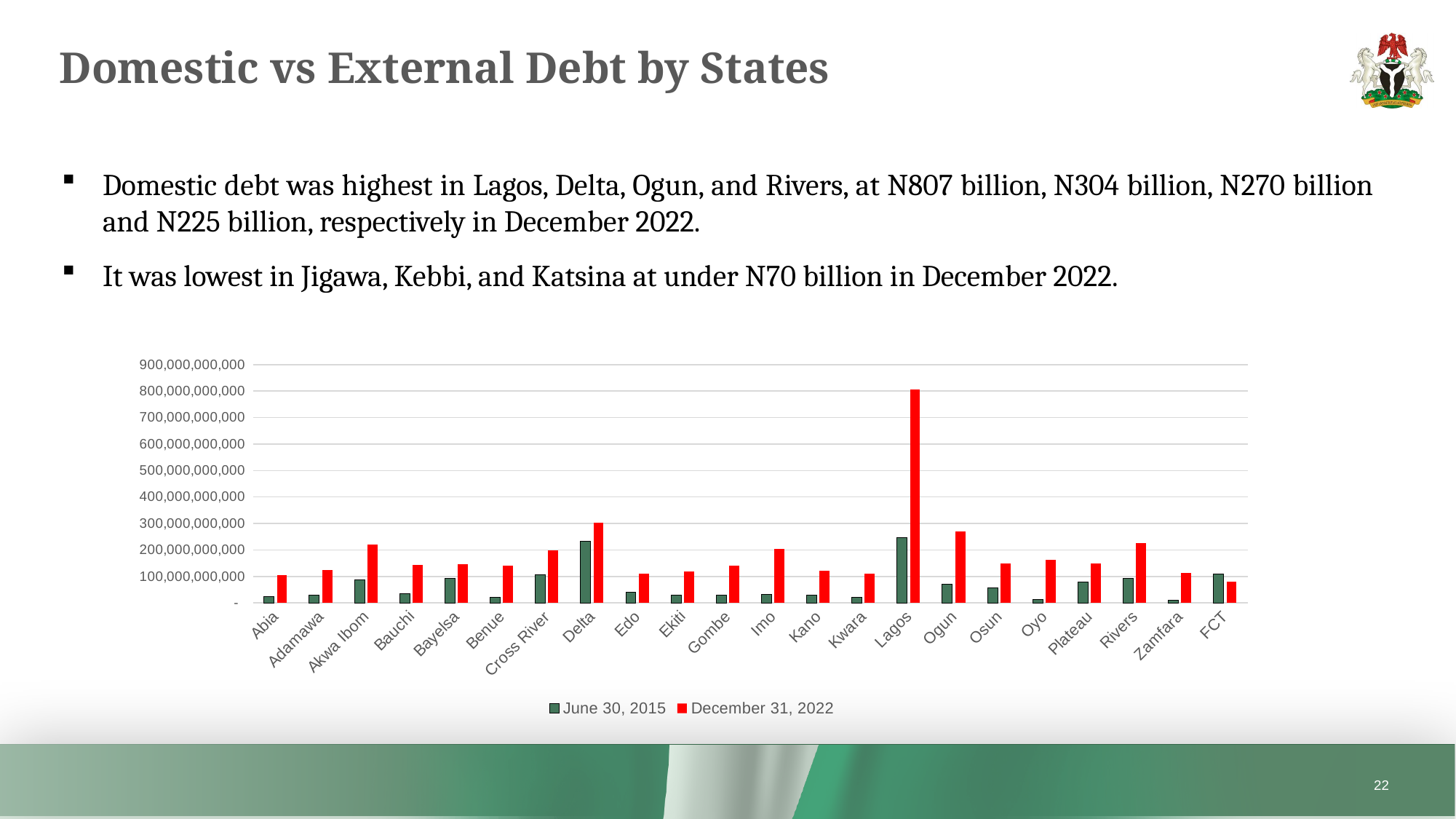
Is the December 31, 2022 value for Rivers greater or less than 200,000,000,000? greater Which category has the lowest December 31, 2022 value in the chart? FCT Is the December 31, 2022 value for Lagos greater or less than 700,000,000,000? greater What are the two series named in the chart legend? June 30, 2015 and December 31, 2022 Is the June 30, 2015 value for Zamfara greater or less than 100,000,000,000? less Which category has the highest December 31, 2022 value in the chart? Lagos What kind of chart is shown on the slide? bar chart For FCT, which series has the larger value: June 30, 2015 or December 31, 2022? June 30, 2015 How many states/categories are shown on the x axis of the chart? 22 How many series does the legend of the chart list? 2 Which has the larger December 31, 2022 value: Ogun or Rivers? Ogun